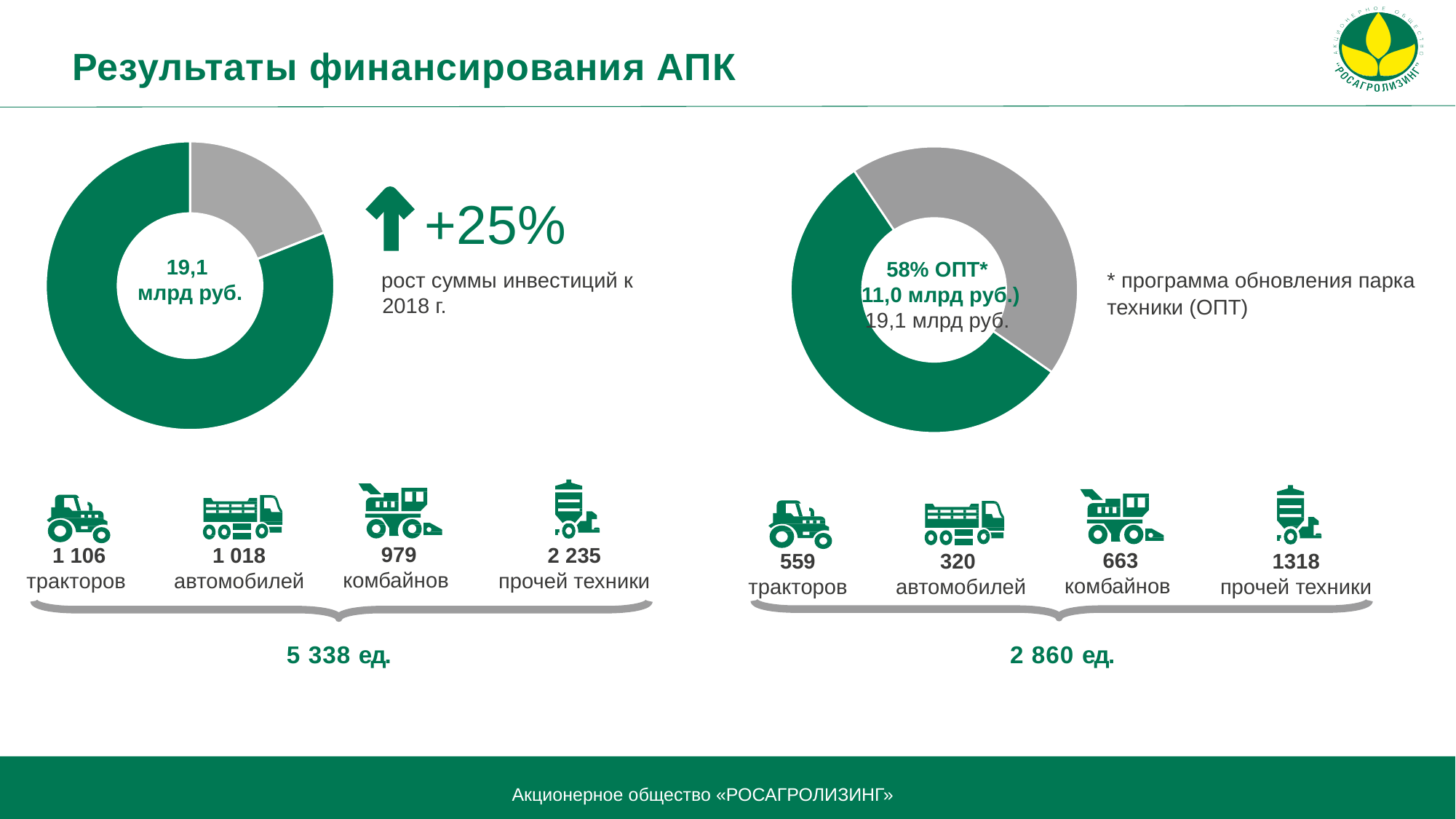
What value is printed in the centre of the left donut chart? 19,1 млрд руб. What percentage growth in investment compared to 2018 is printed next to the left donut chart? +25% What amount in billions of roubles corresponds to the ОПТ* share in the right donut chart? 11,0 млрд руб. What kind of chart is shown on the left side of the slide? Donut (pie) chart What total number of units is printed under the equipment row below the right chart? 2 860 ед. In the right donut chart, what share is labelled as ОПТ*? 58% In the right donut chart, which slice is larger, the green one or the grey one? green In the left donut chart, which slice is larger, the green one or the grey one? green In the row of equipment figures below the left chart, how many тракторов are listed? 1 106 How many slices does the left donut chart have? 2 In the row of equipment figures below the right chart, which category has the lowest number? автомобилей In the row of equipment figures below the left chart, which category has the highest number? прочей техники